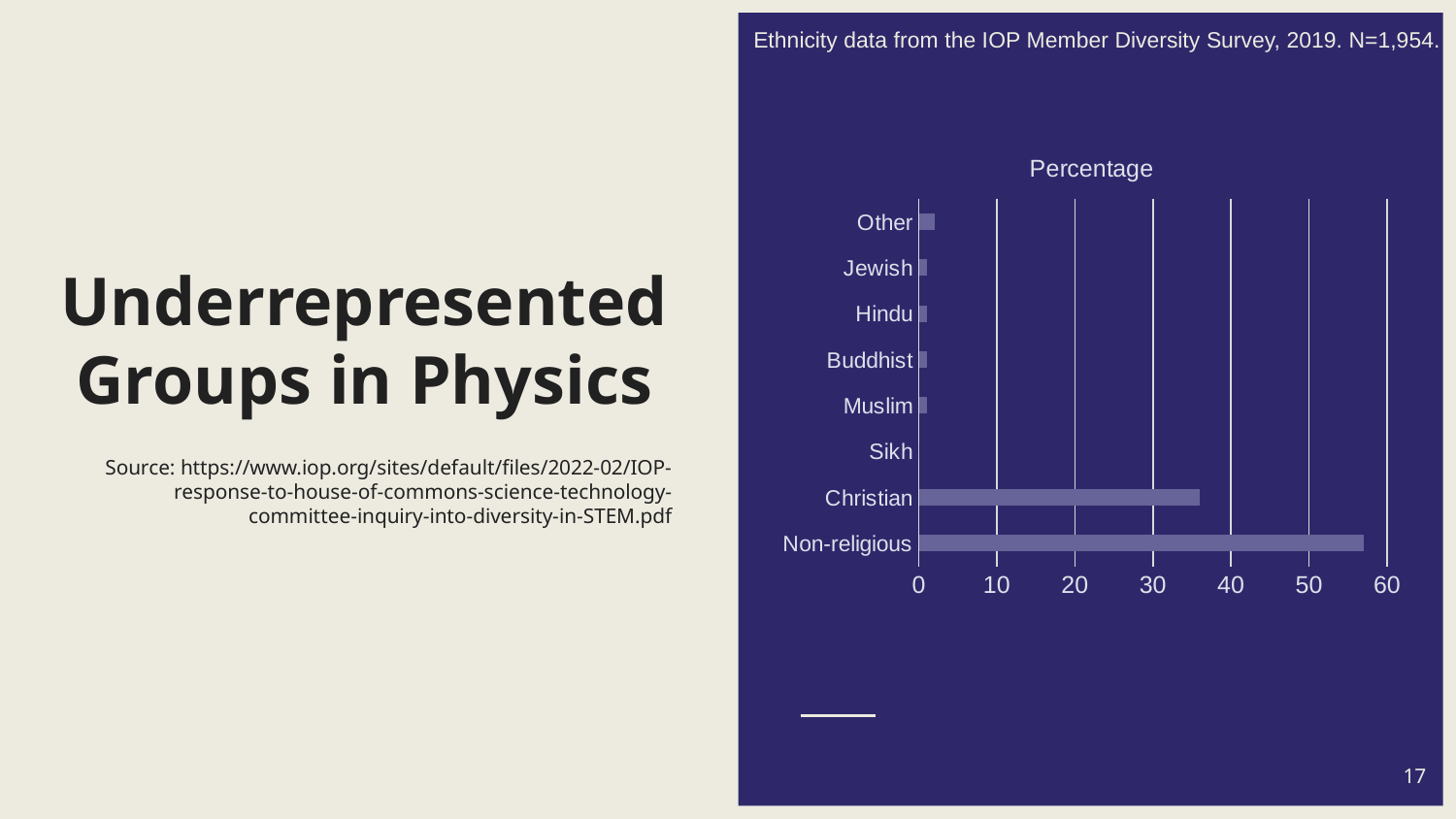
What kind of chart is shown on the slide? Bar chart What is the highest value shown on the chart's horizontal axis? 60 Which is larger, the value for Muslim or the value for Christian? Christian How many categories are shown on the chart? 8 Which category has the highest percentage? Non-religious Which category has the lowest percentage? Sikh Is the value for Non-religious greater or less than 50? greater What is the title of the chart? Percentage Is the value for Christian greater or less than 30? greater Which is larger, the value for Christian or the value for Non-religious? Non-religious Is the value for Christian greater or less than 40? less